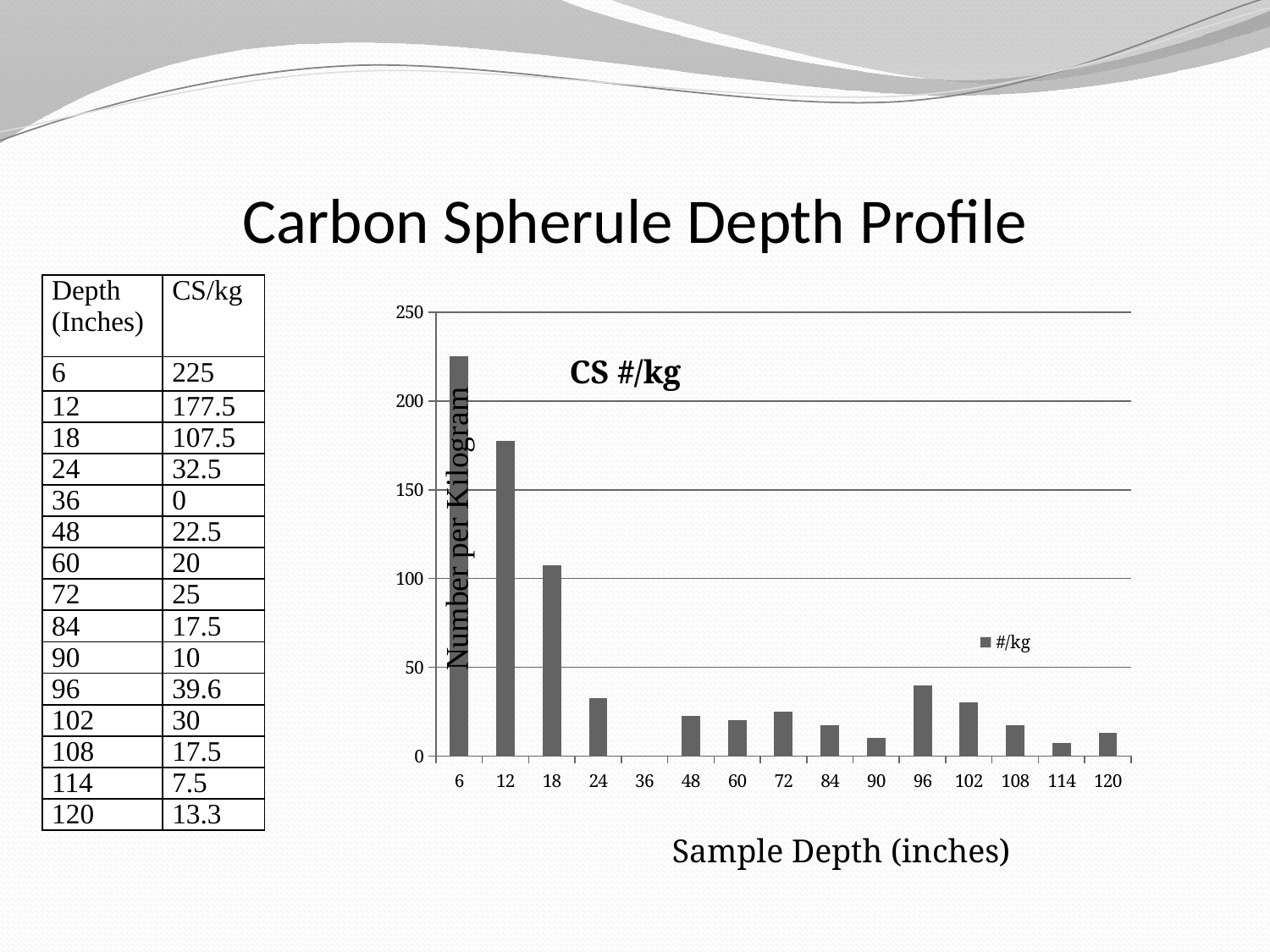
What is the title of the chart? CS #/kg Which sample depth has the highest number per kilogram? 6 Do the values generally rise or fall from a depth of 6 inches to a depth of 36 inches? fall How many depth categories are plotted on the x axis of the chart? 15 What is the CS/kg value at a depth of 96 inches? 39.6 Which sample depth has the lowest number per kilogram? 36 Is the value for a depth of 18 inches greater or less than 100? greater What is the CS/kg value at a depth of 12 inches? 177.5 How many series does the chart legend list? 1 What type of chart is shown on the slide? bar chart Which has a larger CS/kg value, a depth of 24 inches or a depth of 102 inches? 24 inches What is the difference in CS/kg between depths of 6 inches and 18 inches? 117.5